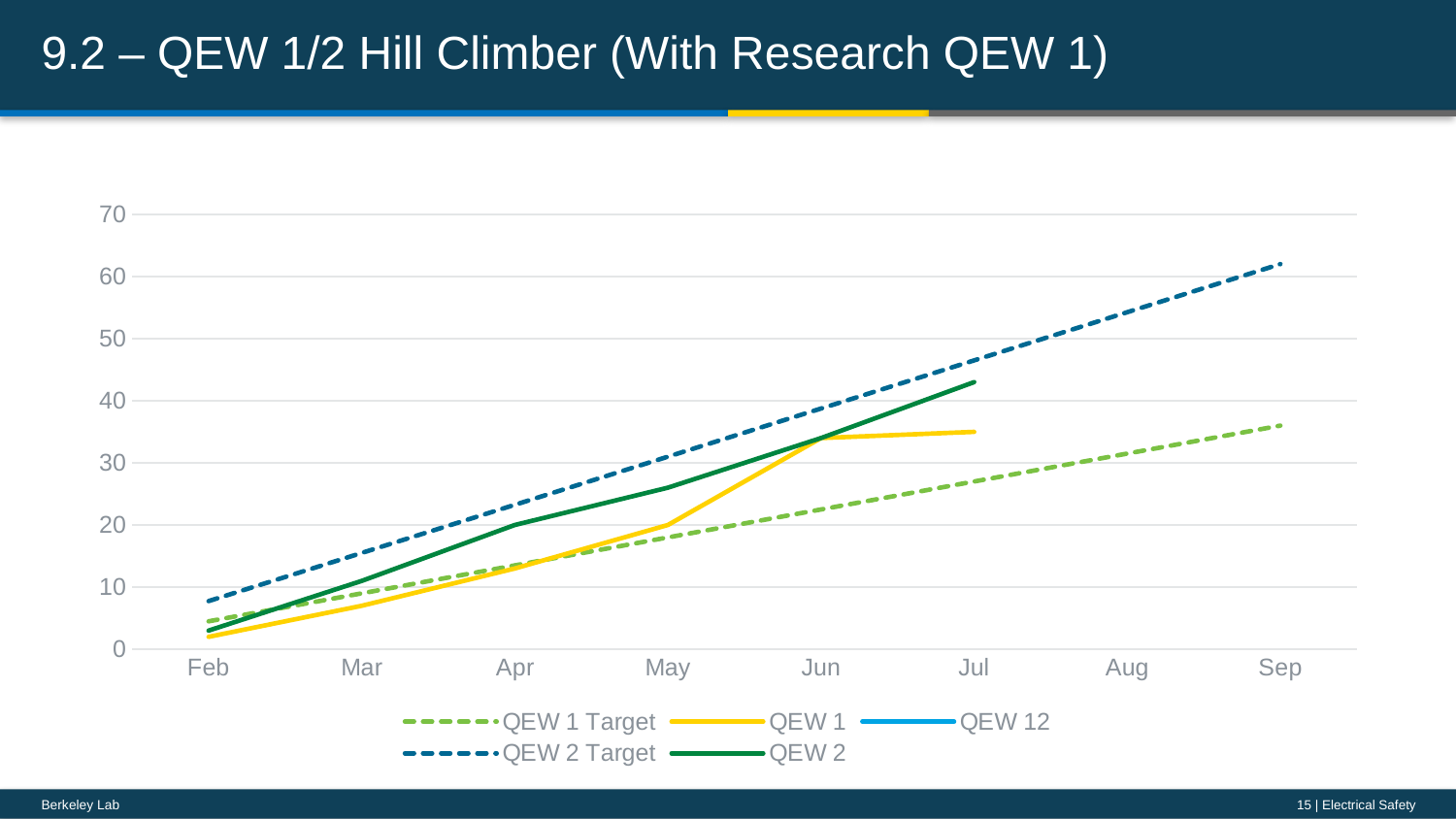
In Sep, which is larger, QEW 1 Target or QEW 2 Target? QEW 2 Target What kind of chart is shown on the slide? line chart How many series does the legend list? 5 Is the value for QEW 1 in Jul greater or less than 40? less Is the value for QEW 1 in Feb greater or less than 10? less Is the value for QEW 2 Target in Sep greater or less than 50? greater How many months are shown on the x axis? 8 Does the QEW 2 line rise or fall from Feb to Jul? rise What is the title of the slide containing the chart? 9.2 – QEW 1/2 Hill Climber (With Research QEW 1) In Jul, which is larger, QEW 1 or QEW 2? QEW 2